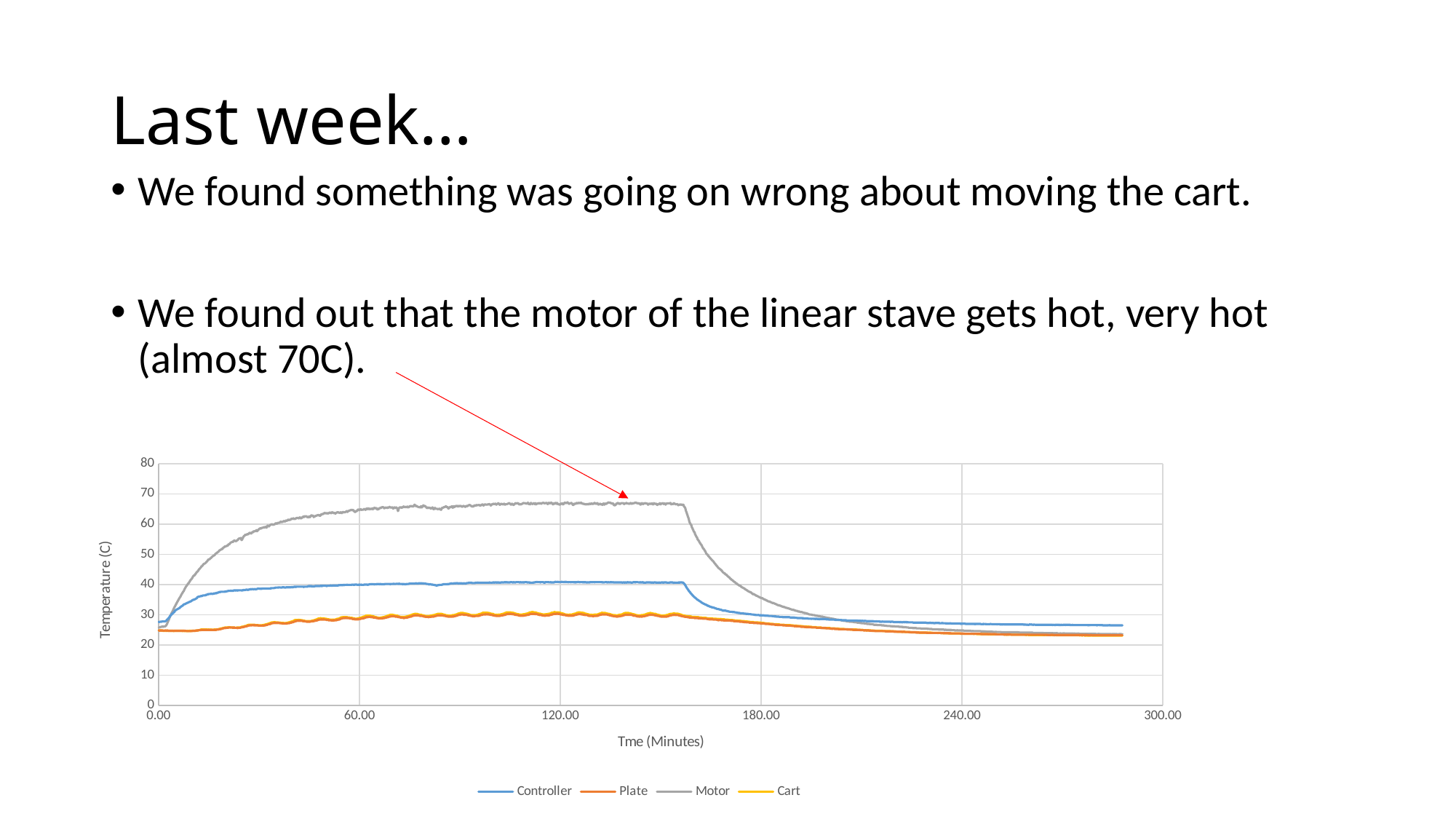
What kind of chart is shown on the slide? line chart Is the Controller series at 120 minutes greater or less than 50? less What is the title of the chart's horizontal axis? Tme (Minutes) How many series does the chart's legend list? 4 What is the title of the chart's vertical axis? Temperature (C) Is the peak value of the Motor series greater or less than 70? less Which series reaches the highest temperature on the chart? Motor Is the Controller series at 120 minutes greater or less than 30? greater At 120 minutes, which series is higher, Motor or Controller? Motor Does the Motor series rise or fall between 180 and 240 minutes? fall